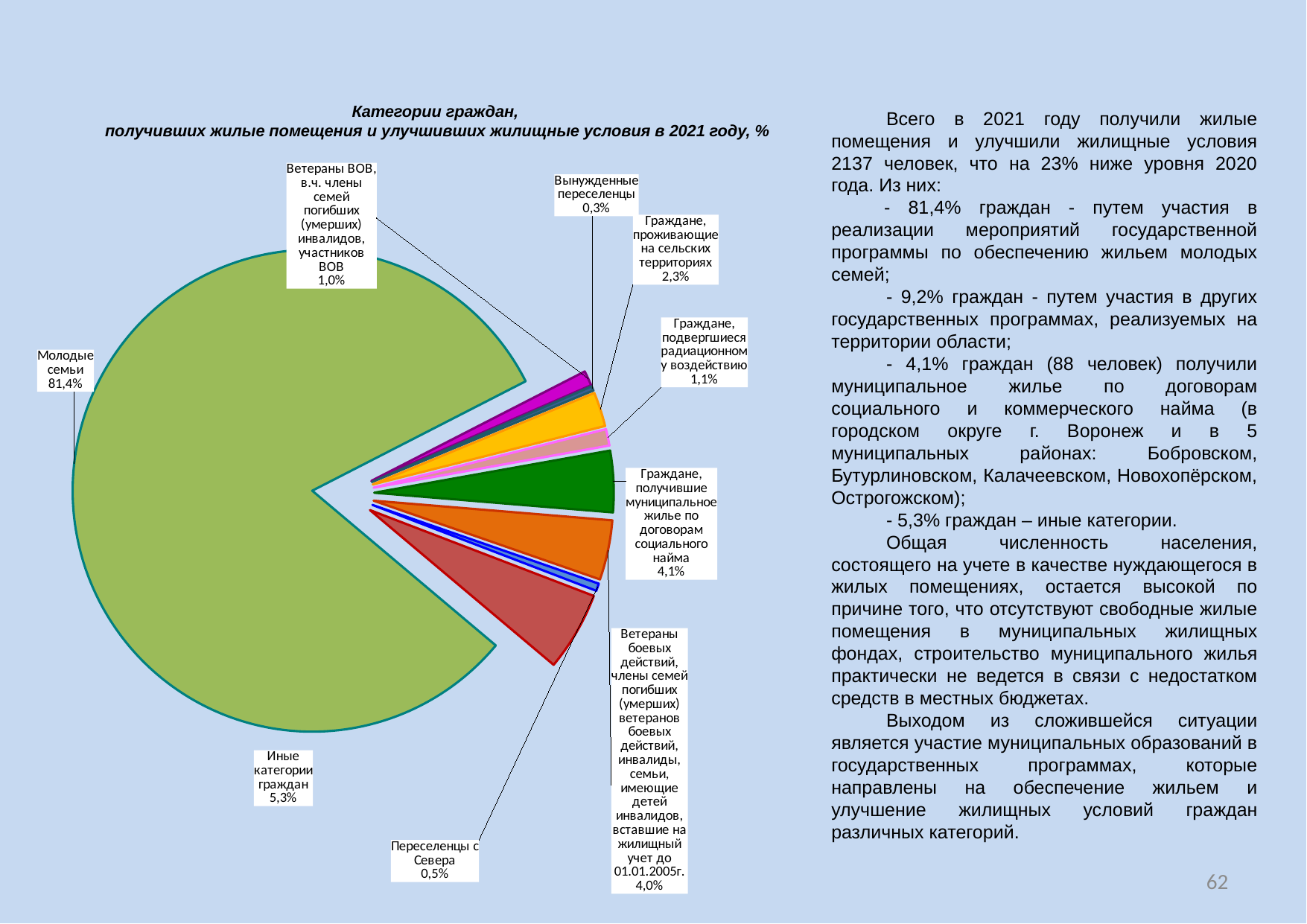
Which category has the largest share of the pie? Молодые семьи What year does the chart title refer to? 2021 What percentage is shown for "Иные категории граждан"? 5,3% How many categories (slices) are labelled in the pie chart? 9 What percentage is shown for "Граждане, проживающие на сельских территориях"? 2,3% What share of the pie is labelled for "Молодые семьи"? 81,4% Which is larger: the share for "Граждане, получившие муниципальное жилье по договорам социального найма" or the share for "Ветераны боевых действий..."? Граждане, получившие муниципальное жилье по договорам социального найма Which category has the smallest share of the pie? Вынужденные переселенцы What percentage is shown for "Граждане, подвергшиеся радиационному воздействию"? 1,1% What is the difference in percentage points between "Иные категории граждан" and "Граждане, получившие муниципальное жилье по договорам социального найма"? 1,2 What kind of chart is shown on the slide? pie chart What percentage is shown for "Переселенцы с Севера"? 0,5%